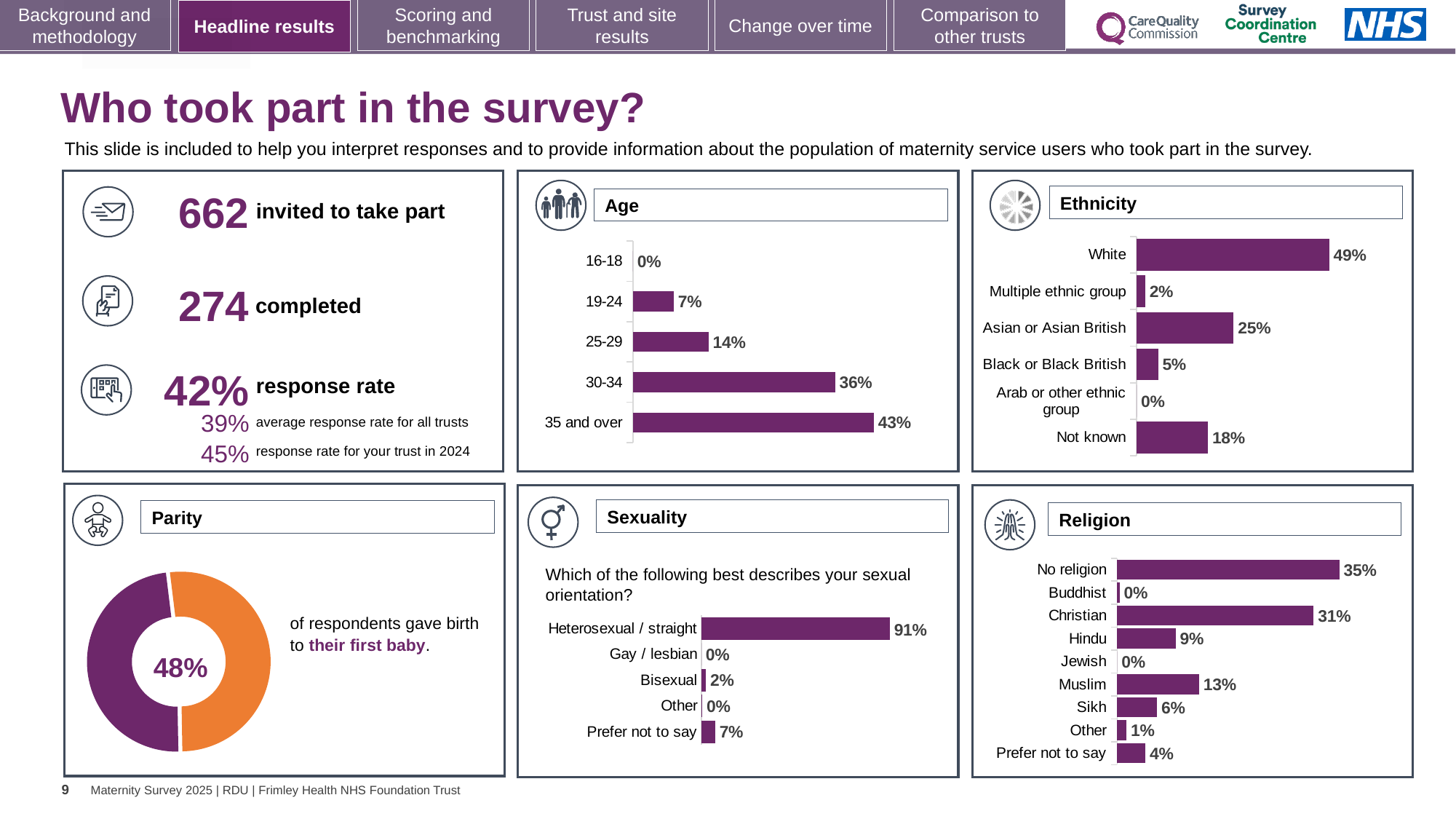
How many categories does the Ethnicity chart show? 6 In the Age chart, what is the difference between the 30-34 and 25-29 percentages? 22% In the Ethnicity chart, which category has the highest percentage? White In the Parity chart, what percentage of respondents gave birth to their first baby? 48% In the Age chart, what percentage of respondents were aged 35 and over? 43% What kind of chart is the Parity chart? Donut chart How many categories does the Religion chart show? 9 In the Sexuality chart, what percentage of respondents answered Prefer not to say? 7% In the Religion chart, what is the difference between No religion and Christian? 4% In the Ethnicity chart, what percentage of respondents were Asian or Asian British? 25% In the Religion chart, which is larger, Christian or Muslim? Christian In the Age chart, which age group has the highest percentage? 35 and over